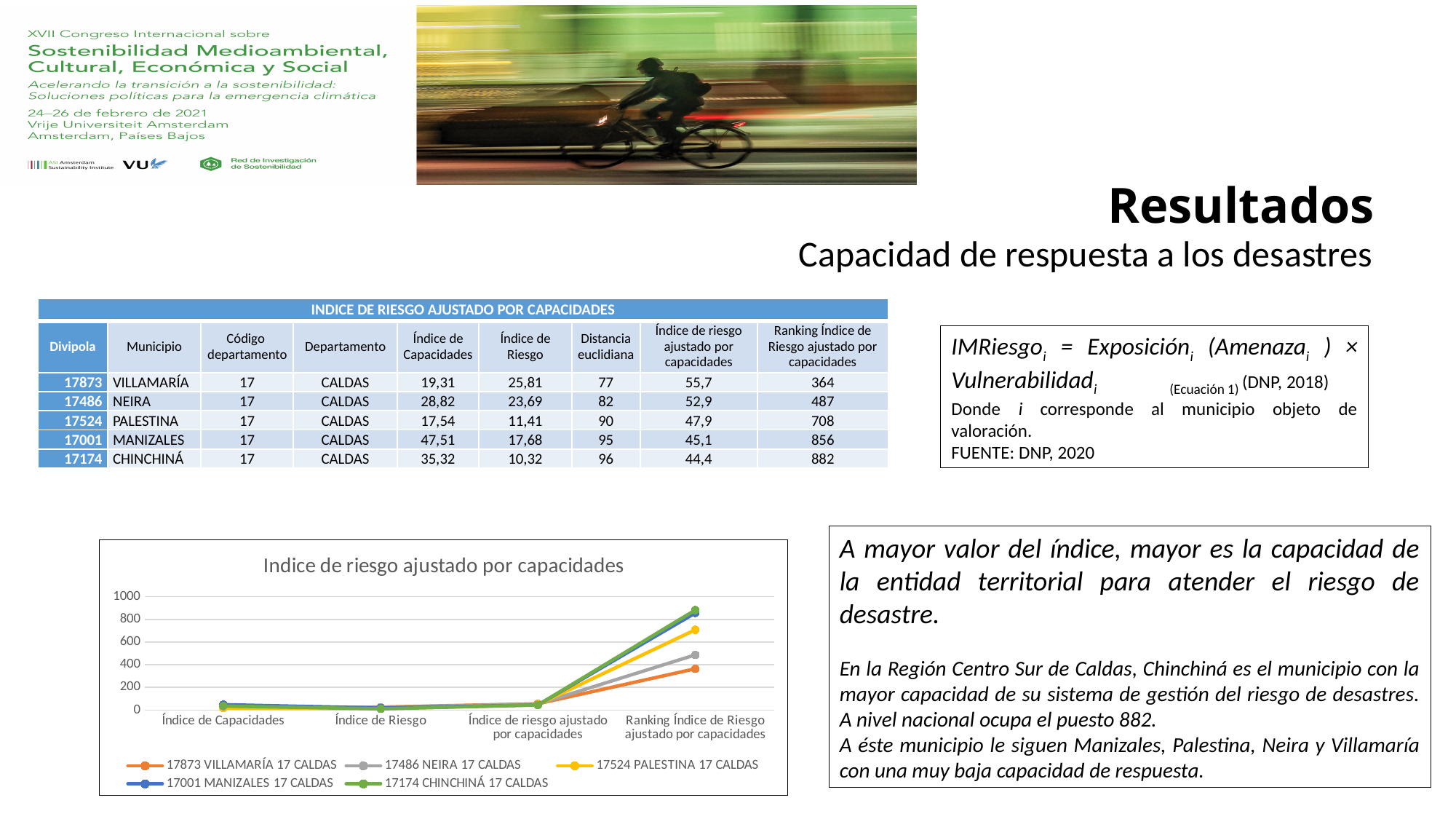
What colour is the line for 17873 VILLAMARÍA 17 CALDAS in the chart? orange What is the 'Índice de riesgo ajustado por capacidades' value for CHINCHINÁ, as printed in the table on the slide? 44,4 What is the title of the chart? Indice de riesgo ajustado por capacidades How many series does the chart legend list? 5 Is the 'Ranking Índice de Riesgo ajustado por capacidades' value for 17873 VILLAMARÍA 17 CALDAS greater or less than 400? less Is the 'Ranking Índice de Riesgo ajustado por capacidades' value for 17486 NEIRA 17 CALDAS greater or less than 600? less Which is larger for 'Ranking Índice de Riesgo ajustado por capacidades': 17524 PALESTINA 17 CALDAS or 17486 NEIRA 17 CALDAS? 17524 PALESTINA 17 CALDAS Is the 'Ranking Índice de Riesgo ajustado por capacidades' value for 17524 PALESTINA 17 CALDAS greater or less than 600? greater What is the 'Ranking Índice de Riesgo ajustado por capacidades' value for PALESTINA, as printed in the table on the slide? 708 What kind of chart is shown on the slide? line chart How many categories are shown along the x axis of the chart? 4 Which series has the lowest value for 'Ranking Índice de Riesgo ajustado por capacidades'? 17873 VILLAMARÍA 17 CALDAS